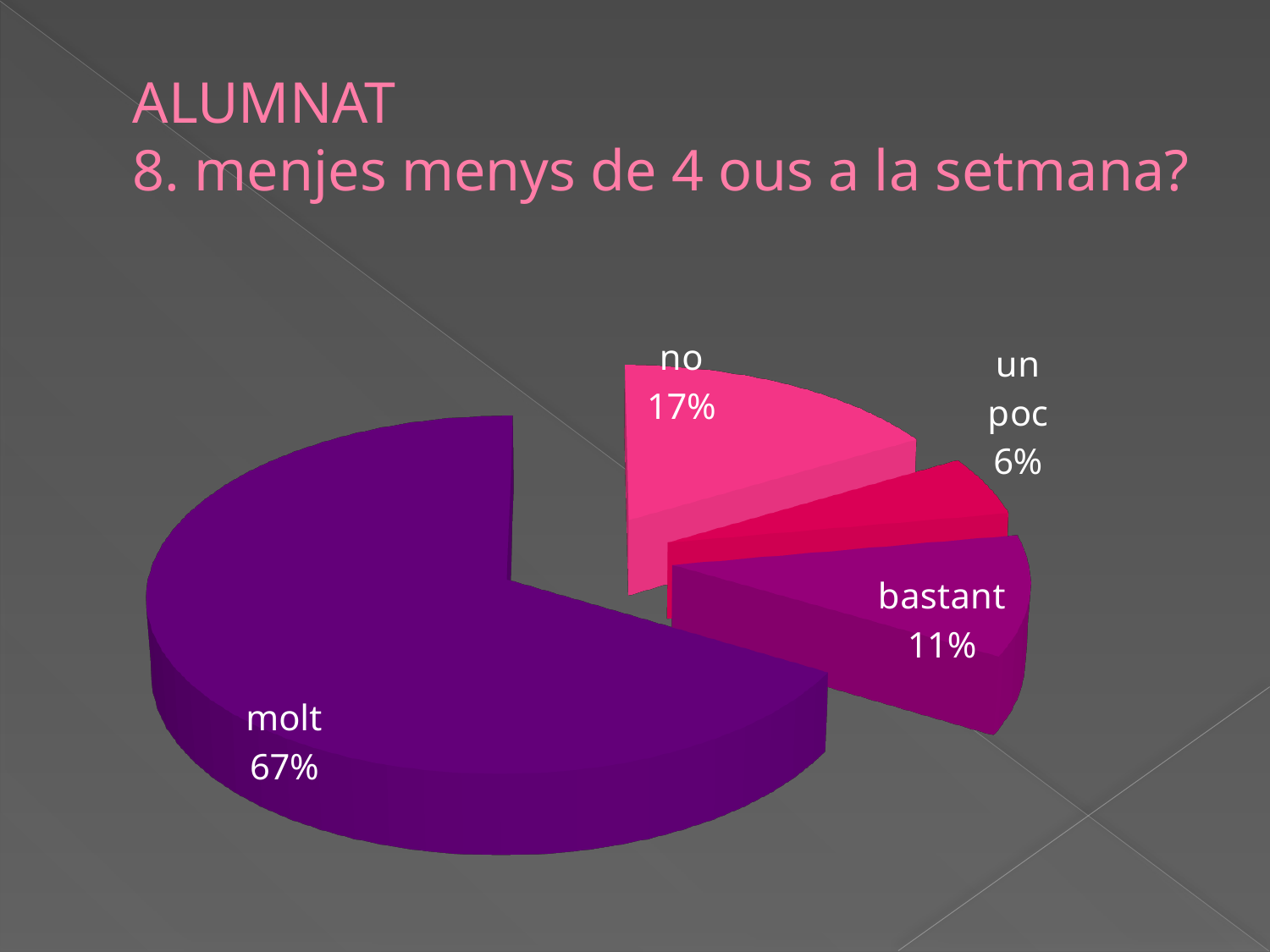
Which category has the largest slice of the pie? molt How many slices does the pie chart have? 4 What is the value shown for the "no" slice? 17% Which is larger, the "bastant" slice or the "un poc" slice? bastant What is the value shown for the "bastant" slice? 11% What is the difference in percentage points between the "molt" slice and the "no" slice? 50 What is the value shown for the "un poc" slice? 6% What kind of chart is shown on the slide? pie chart What is the difference in percentage points between the "no" slice and the "bastant" slice? 6 What share of the pie does the "molt" slice represent? 67% Which category has the smallest slice of the pie? un poc What question is shown as the title above the chart? 8. menjes menys de 4 ous a la setmana?